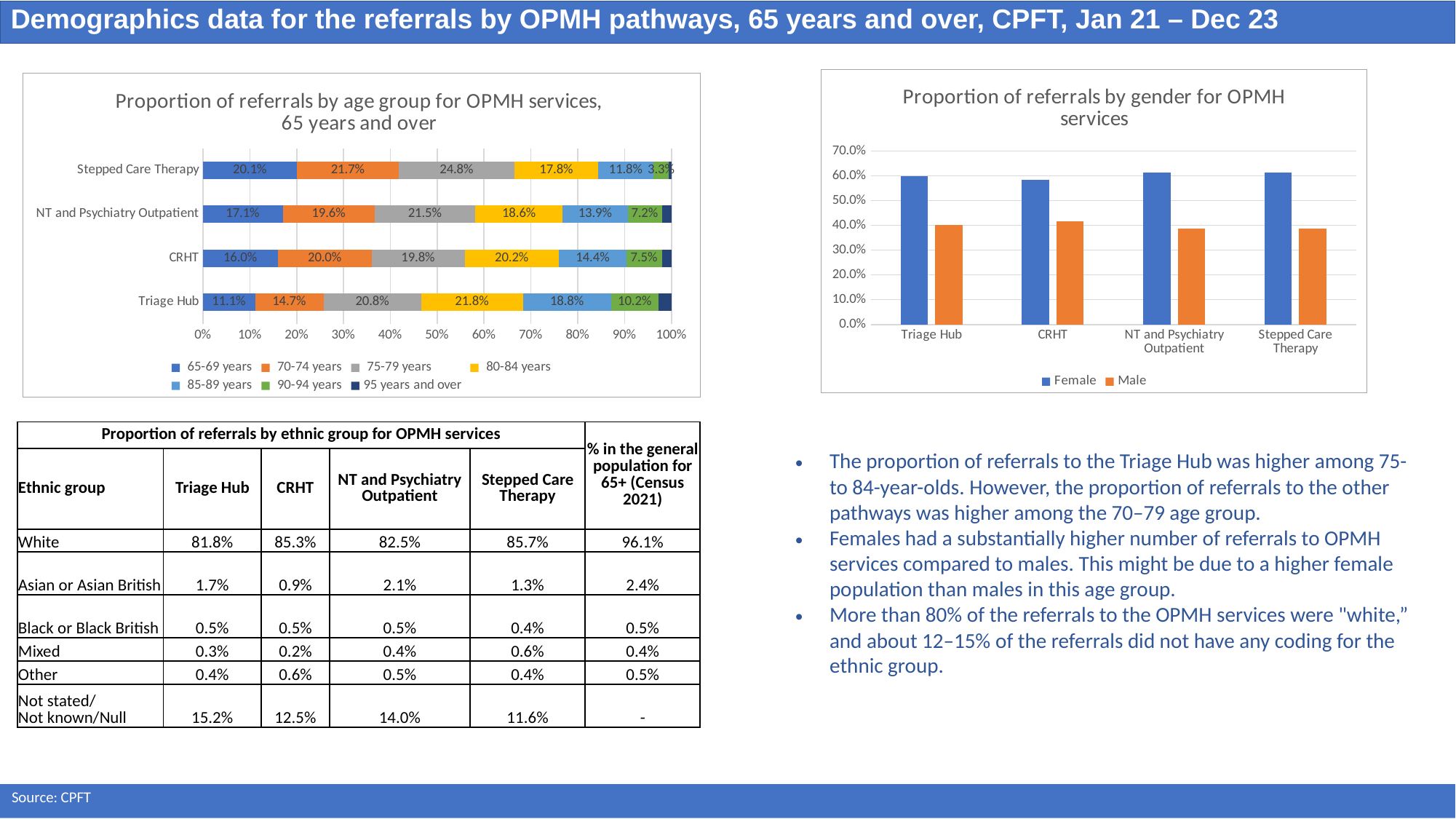
How many series does the legend of the age group chart list? 7 How many pathways (categories) are shown in the age group chart? 4 In the age group chart, what is the value for 65-69 years for Triage Hub? 11.1% In the age group chart, what is the value for 75-79 years for Stepped Care Therapy? 24.8% How many series does the legend of the "Proportion of referrals by gender for OPMH services" chart list? 2 In the age group chart, what is the difference between the 85-89 years value for Triage Hub and for Stepped Care Therapy? 7.0 percentage points In the age group chart, which pathway has the highest proportion of 65-69 years referrals? Stepped Care Therapy In the age group chart, what is the value for 80-84 years for CRHT? 20.2% What kind of chart is "Proportion of referrals by age group for OPMH services, 65 years and over"? Bar chart (stacked) In the gender chart, which is larger for CRHT, Female or Male? Female In the gender chart, is the Female value for Triage Hub greater or less than 50%? greater What kind of chart is "Proportion of referrals by gender for OPMH services"? Bar chart